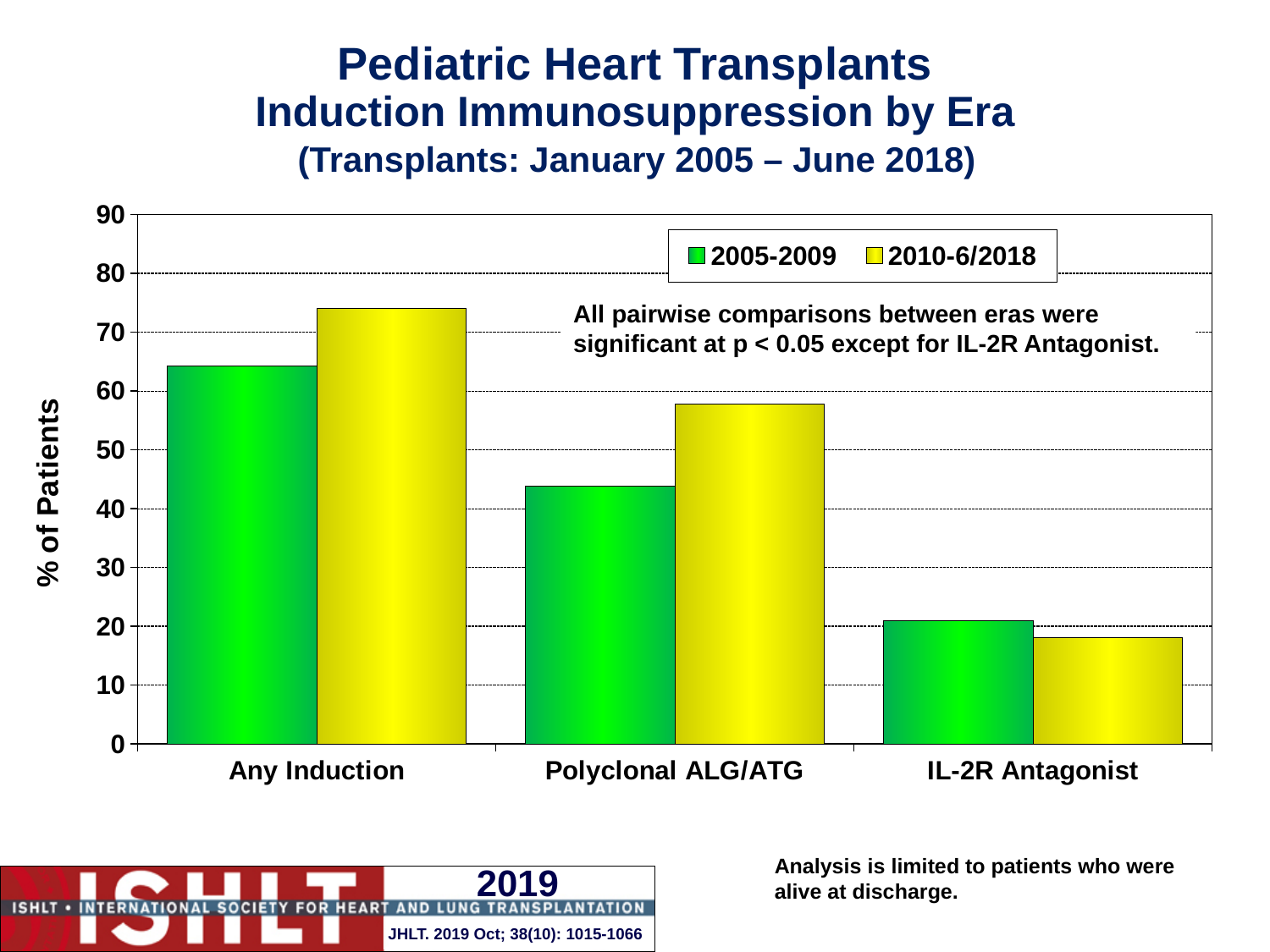
How many series does the legend list? 2 Is the value for Any Induction in 2010-6/2018 greater or less than 70? greater Is the value for Polyclonal ALG/ATG in 2005-2009 greater or less than 50? less Which category and era has the lowest bar? IL-2R Antagonist, 2010-6/2018 What kind of chart is shown on the slide? bar chart For Polyclonal ALG/ATG, which era has the larger value, 2005-2009 or 2010-6/2018? 2010-6/2018 What is the label on the y axis? % of Patients Which category and era has the highest bar? Any Induction, 2010-6/2018 Is the value for Any Induction in 2005-2009 greater or less than 60? greater How many induction categories are shown on the x axis? 3